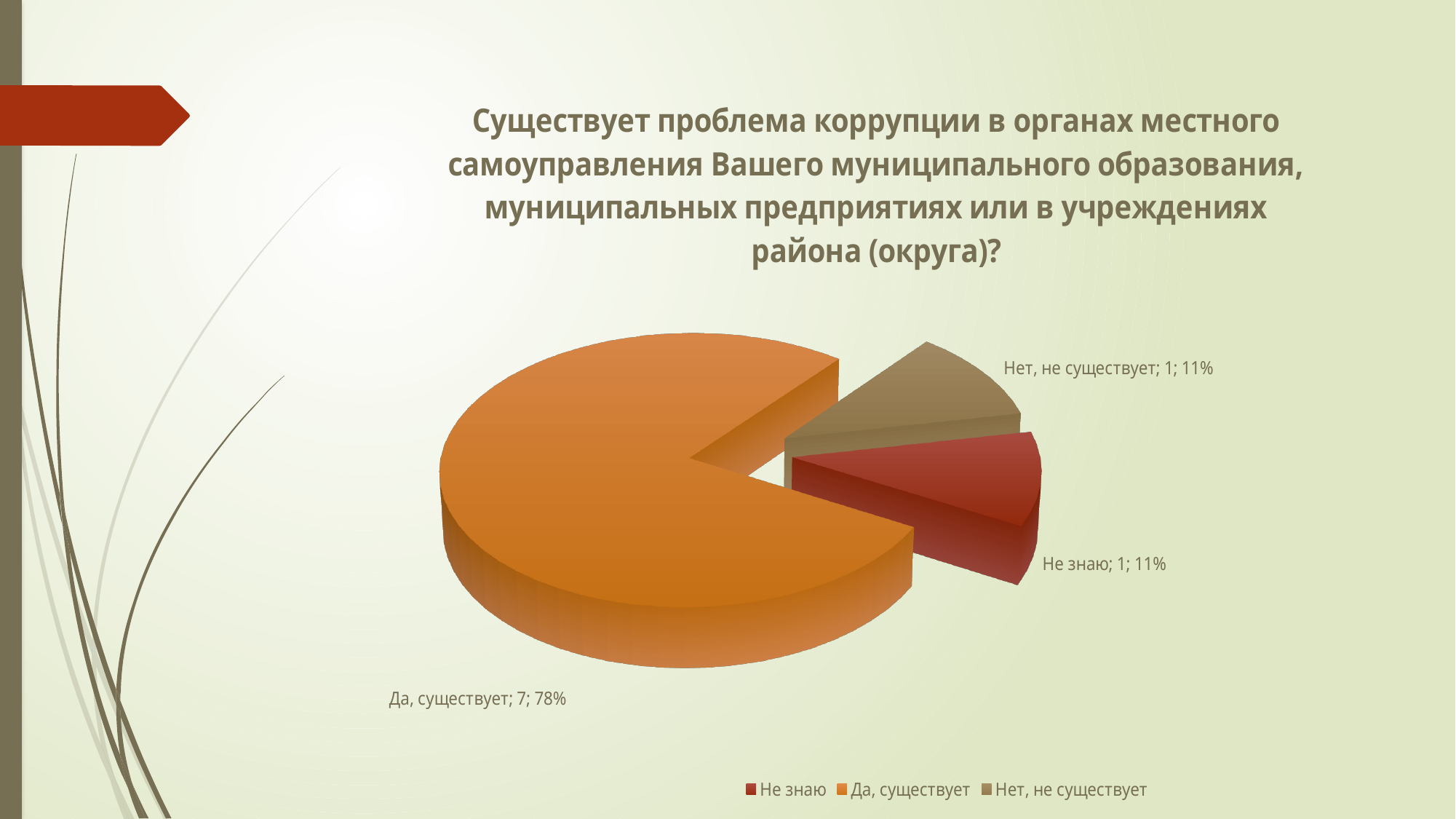
What share of the pie does the slice "Да, существует" represent? 78% How many entries does the legend list? 3 What is the difference in percentage points between the "Да, существует" slice and the "Не знаю" slice? 67 What is the count value shown for "Не знаю"? 1 What share of the pie does the slice "Не знаю" represent? 11% What share of the pie does the slice "Нет, не существует" represent? 11% What kind of chart is shown on the slide? Pie chart Which is larger: the "Да, существует" slice or the "Нет, не существует" slice? Да, существует What is the count value shown for "Да, существует"? 7 What colour is the "Да, существует" slice? Orange How many slices does the pie chart have? 3 Which slice of the pie is the largest? Да, существует